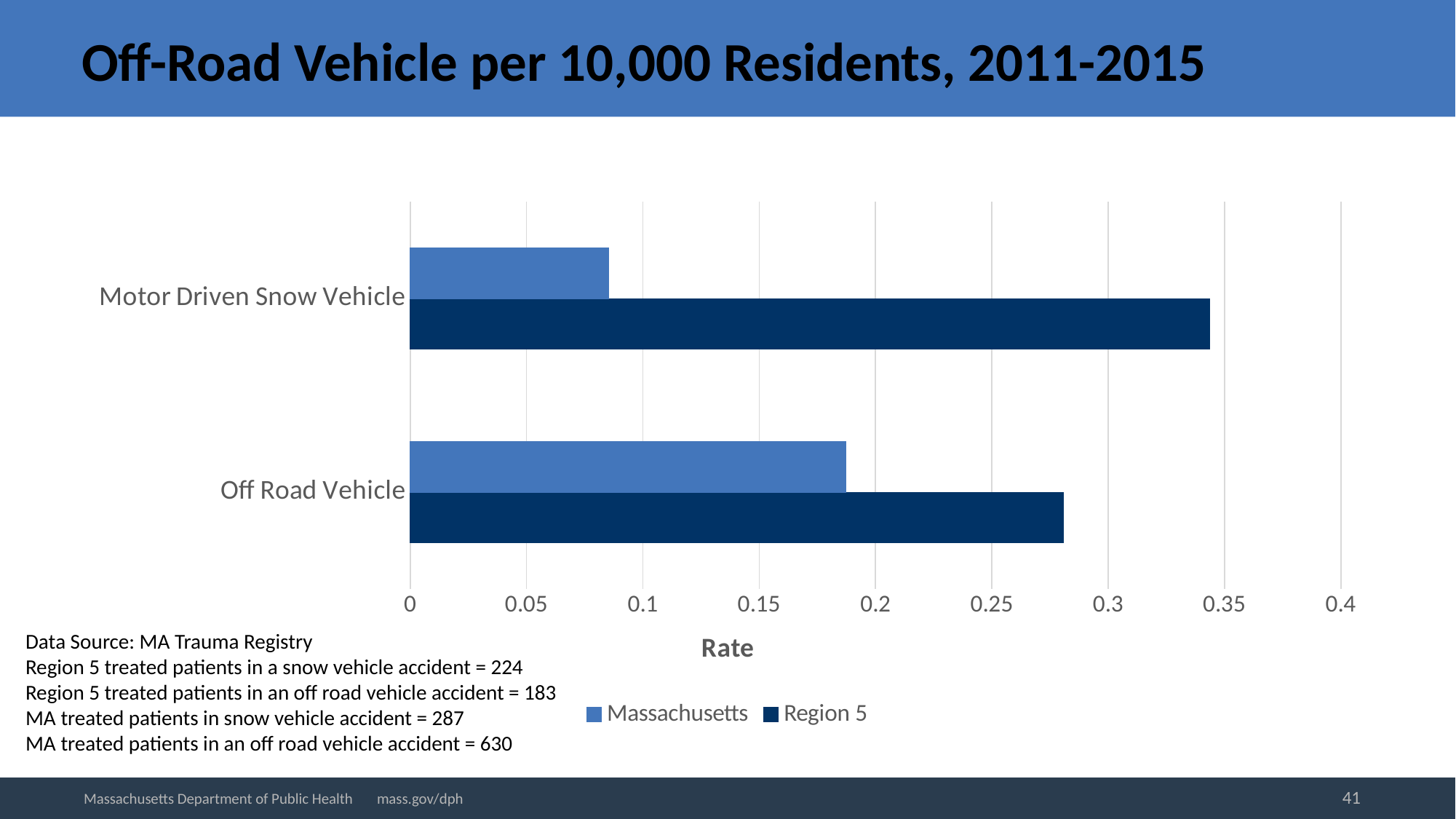
Which series has the longest bar on the chart, and for which category? Region 5, Motor Driven Snow Vehicle Is the Massachusetts value for Motor Driven Snow Vehicle greater or less than 0.1? less For Off Road Vehicle, which is larger: the Massachusetts rate or the Region 5 rate? Region 5 How many categories are shown on the chart? 2 Which bar is the shortest on the chart? Massachusetts, Motor Driven Snow Vehicle For Motor Driven Snow Vehicle, which is larger: the Massachusetts rate or the Region 5 rate? Region 5 Is the Region 5 value for Off Road Vehicle greater or less than 0.3? less How many series does the legend list? 2 What is the label on the horizontal axis of the chart? Rate Is the Region 5 value for Motor Driven Snow Vehicle greater or less than 0.3? greater What kind of chart is shown on the slide? bar chart